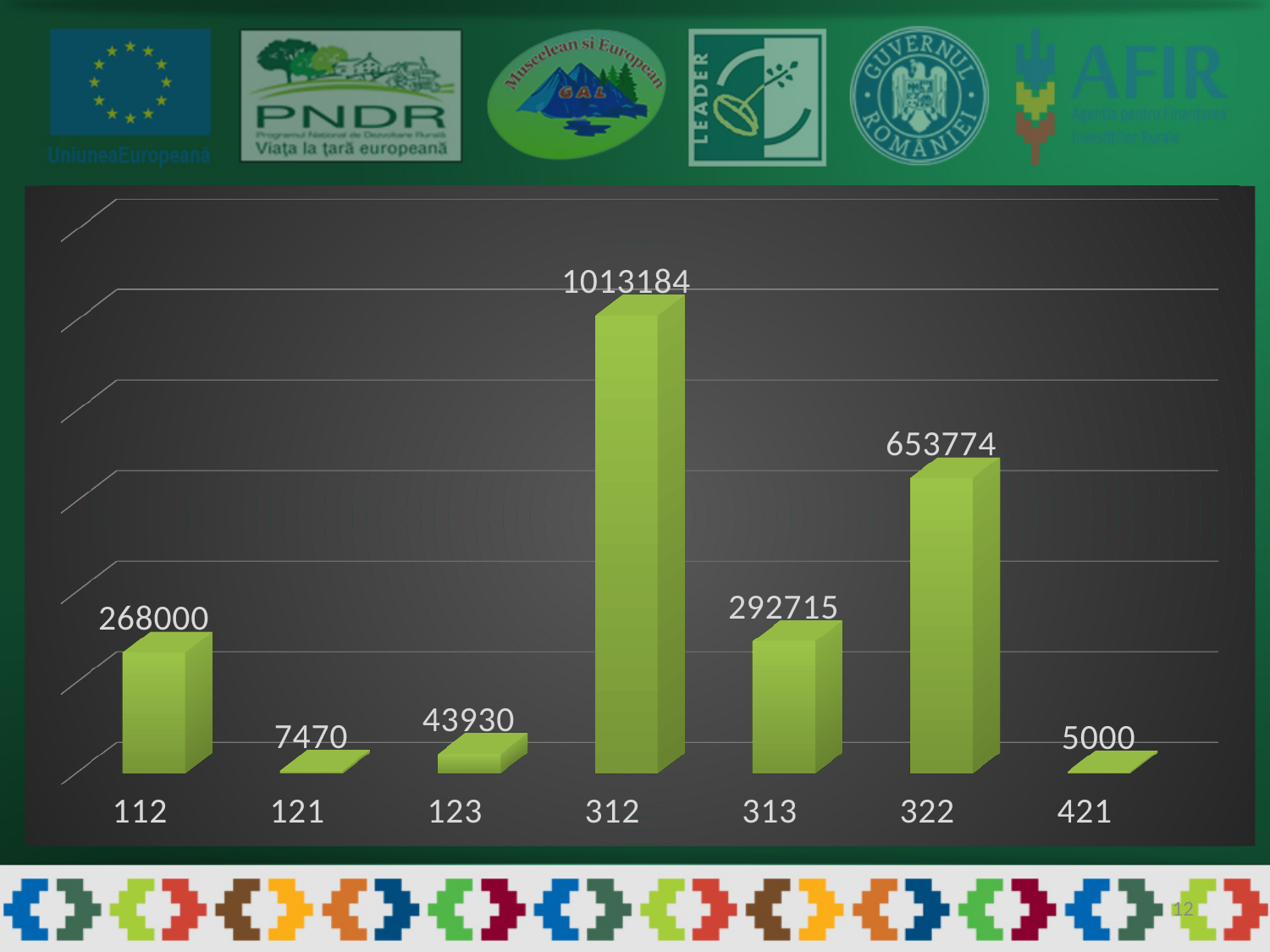
Which has the larger value, category 123 or category 121? 123 What is the difference between the values for 313 and 112? 24715 Which has the larger value, category 112 or category 313? 313 What is the difference between the values for 312 and 322? 359410 Which category has the lowest value? 421 Which category has the highest value? 312 What is the value for category 322? 653774 What is the value for category 121? 7470 What is the value for category 421? 5000 How many categories are shown on the x axis? 7 What kind of chart is shown on the slide? bar chart What is the value for category 312? 1013184